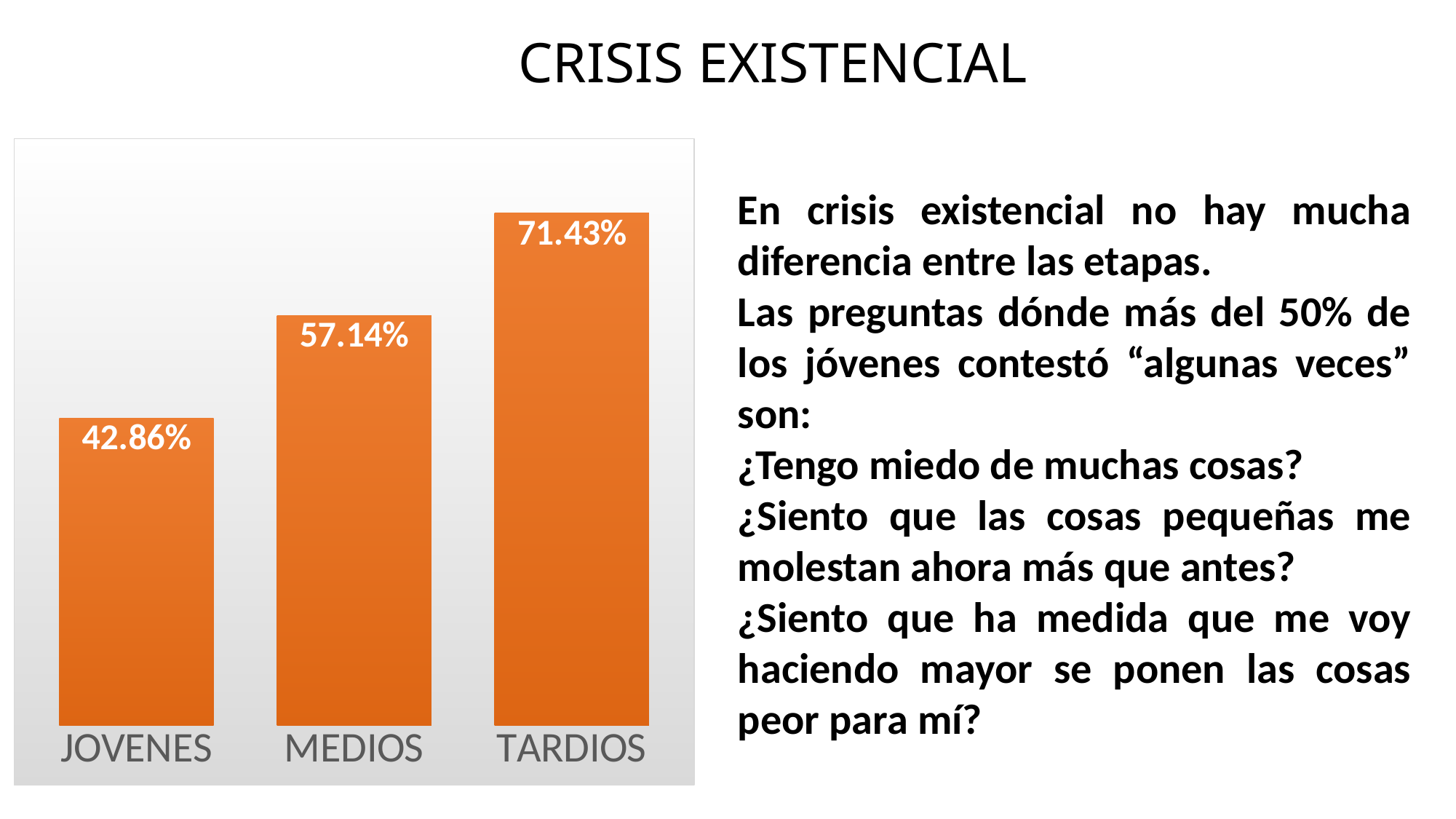
Do the values rise or fall from JOVENES to TARDIOS? Rise What is the difference between the values for MEDIOS and JOVENES? 14.28% What is the value for TARDIOS? 71.43% Which category has the lowest value? JOVENES How many categories are shown in the chart? 3 What colour are the bars in the chart? Orange What kind of chart is shown on the slide? Bar chart What is the difference between the values for TARDIOS and JOVENES? 28.57% What is the value for JOVENES? 42.86% What is the value for MEDIOS? 57.14% Which is larger, the value for MEDIOS or the value for TARDIOS? TARDIOS Which category has the highest value? TARDIOS